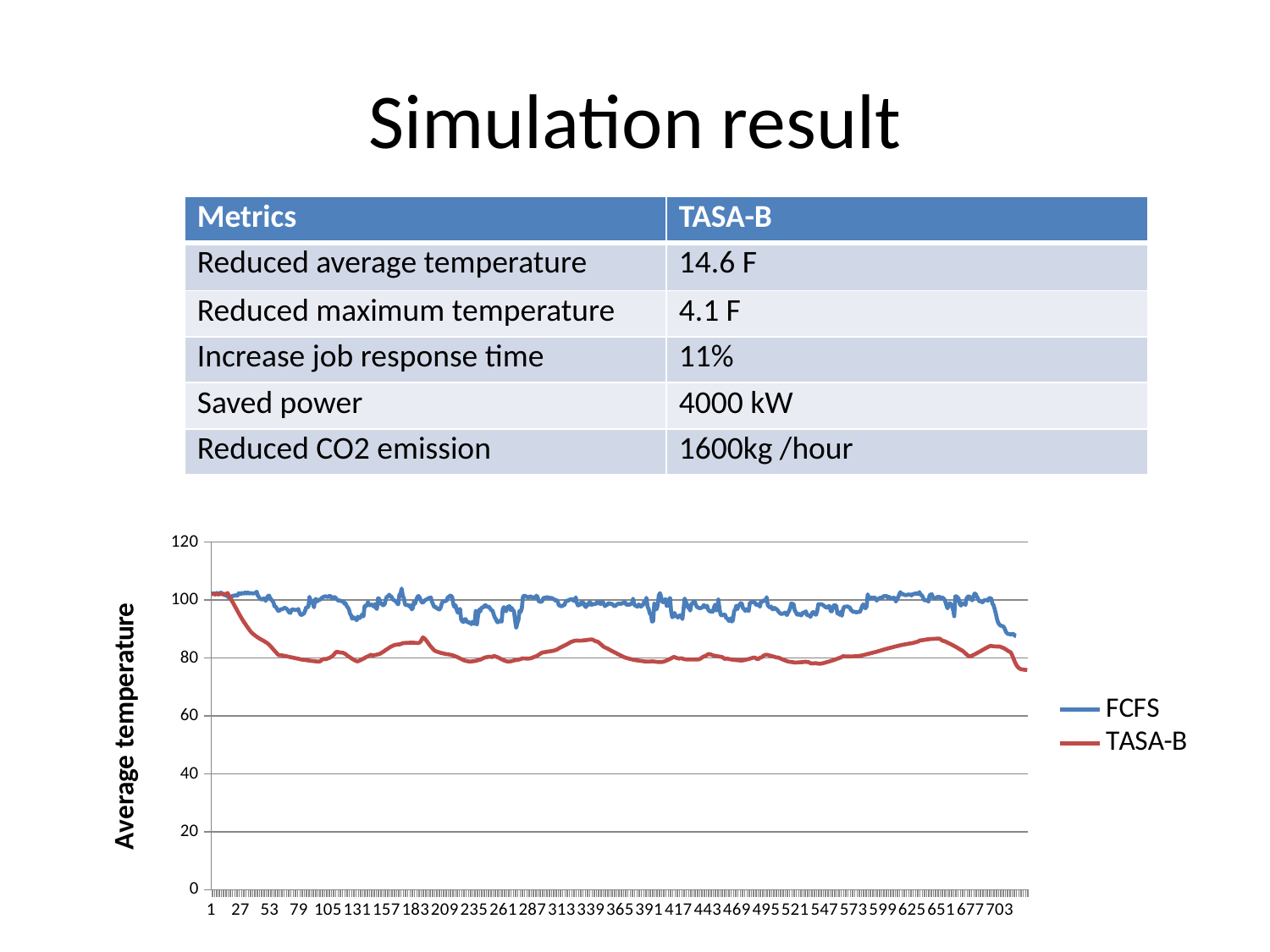
Does the TASA-B line rise or fall between x = 1 and x = 53? fall Which series has the higher average temperature over most of the chart, FCFS or TASA-B? FCFS Is the value for FCFS at x = 209 greater or less than 120? less What is the label on the chart's vertical axis? Average temperature What are the two series named in the chart's legend? FCFS and TASA-B What kind of chart is shown on the slide? line chart Is the value for TASA-B at x = 105 greater or less than 60? greater Is the value for TASA-B at x = 365 greater or less than 100? less Which series has the lower average temperature over most of the chart, FCFS or TASA-B? TASA-B Does the FCFS line rise or fall between x = 651 and x = 703? fall How many series does the chart's legend list? 2